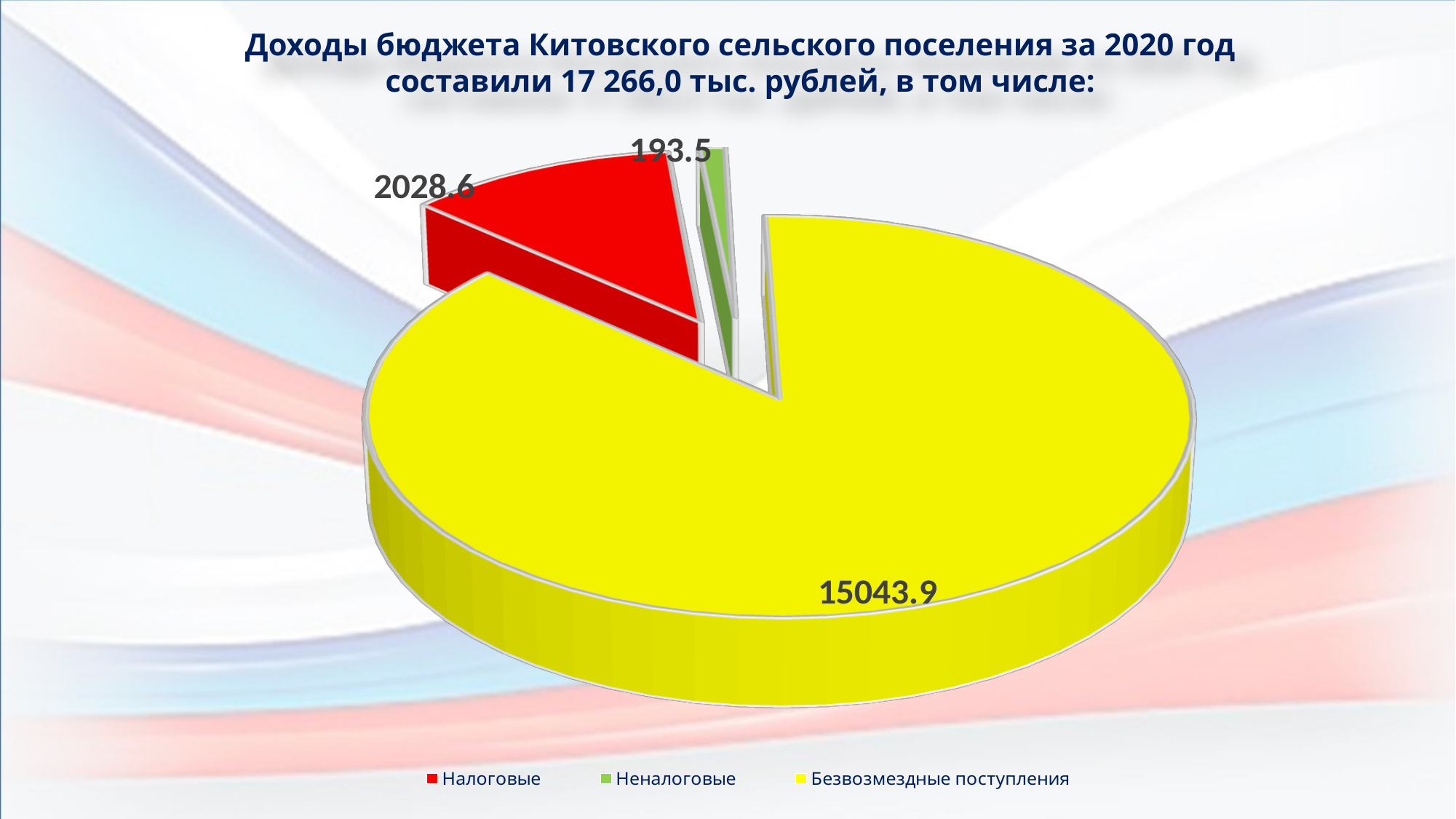
Which category has the largest slice of the pie? Безвозмездные поступления What type of chart is shown on the slide? Pie chart What is the difference between the values for Налоговые and Неналоговые? 1835.1 What is the value for Безвозмездные поступления? 15043.9 What is the value for Неналоговые? 193.5 How many slices does the pie chart have? 3 What is the value for Налоговые? 2028.6 What is the difference between the values for Безвозмездные поступления and Налоговые? 13015.3 Which is larger, Налоговые or Неналоговые? Налоговые What colour is the slice for Налоговые? Red Which category has the smallest slice of the pie? Неналоговые What share of the pie does Безвозмездные поступления represent, to one decimal place? 87.1%